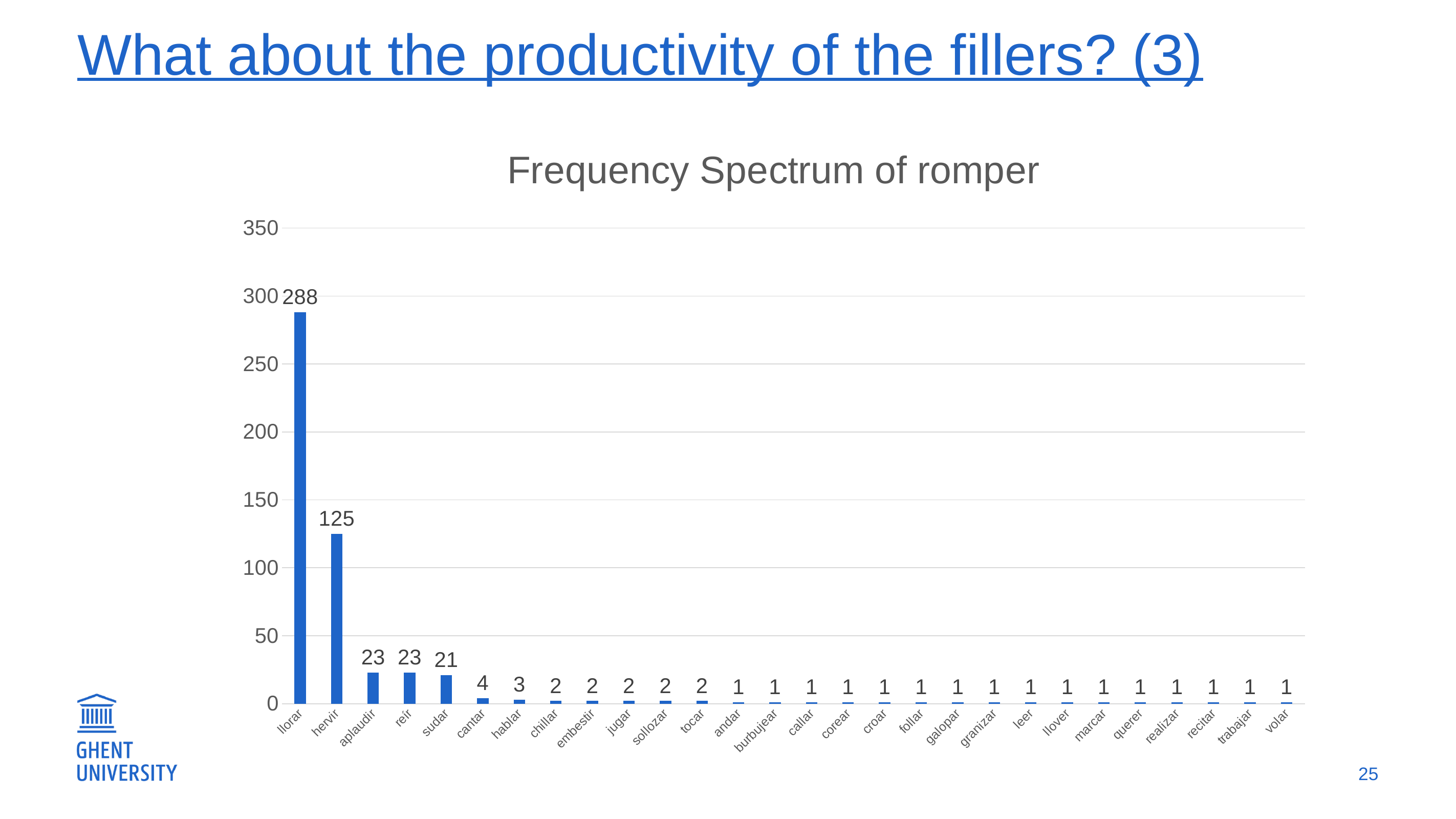
How many categories are shown on the x axis? 28 What is the title of the chart? Frequency Spectrum of romper What is the value for llorar? 288 What is the difference between the values for llorar and hervir? 163 What kind of chart is shown on the slide? bar chart Is the value for llorar greater or less than 250? greater What is the difference between the values for hervir and aplaudir? 102 What is the value for hervir? 125 What is the value for cantar? 4 Which is larger, the value for sudar or the value for hablar? sudar Which category has the highest value? llorar What is the value for sudar? 21